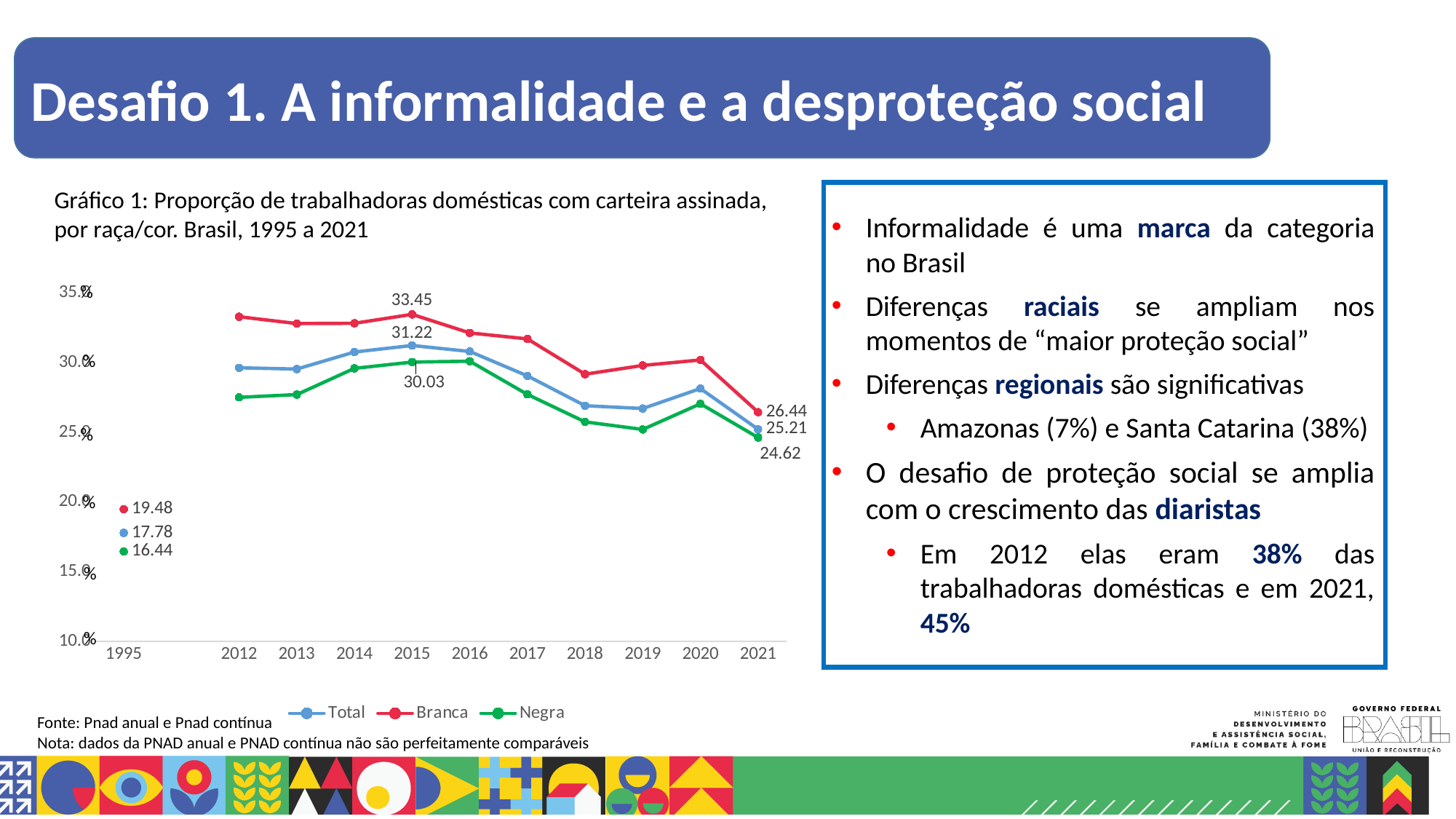
What is the value for Total in 1995? 17.78 What kind of chart is Gráfico 1? line chart What is the difference between the Branca and Negra values in 2021? 1.82 By how much did the Branca value fall from 2015 to 2021? 7.01 What is the value for Branca in 2015? 33.45 Is the value for Branca in 2012 greater or less than 30.0%? greater Does the Branca series rise or fall between 2015 and 2021? fall Which series has the highest value in 2021? Branca In 2015, which is larger: the Total value or the Negra value? Total How many series does the legend of the chart list? 3 How many years are shown on the x axis of the chart? 11 What is the value for Negra in 2021? 24.62